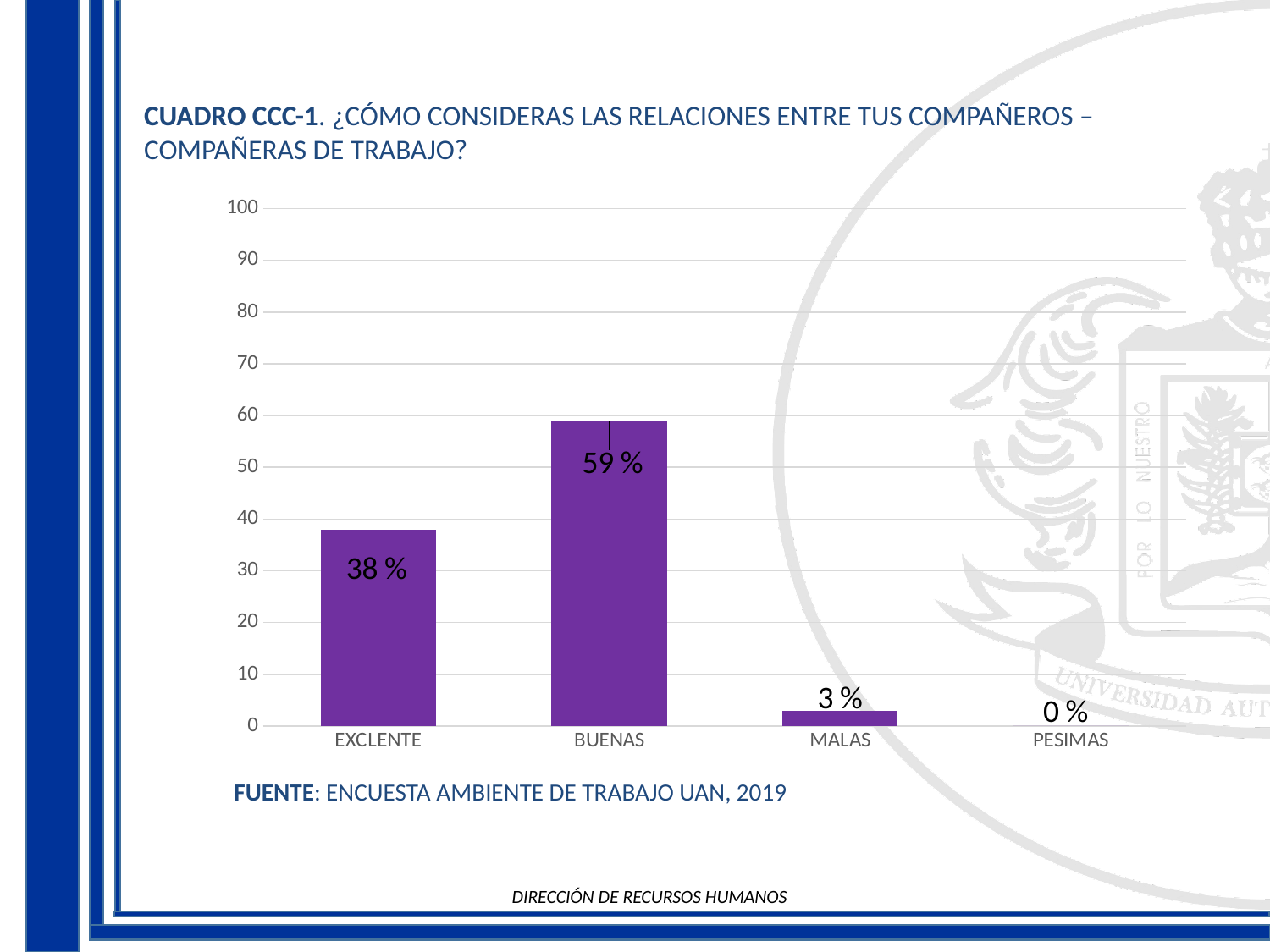
What is the value for MALAS? 3 % How many categories are shown on the x axis? 4 What kind of chart is shown on the slide? bar chart What is the difference between the values for BUENAS and EXCLENTE? 21 % What is the source cited below the chart? ENCUESTA AMBIENTE DE TRABAJO UAN, 2019 What is the value for PESIMAS? 0 % Which category has the lowest value? PESIMAS Which category has the highest value? BUENAS Which is larger, the value for EXCLENTE or the value for MALAS? EXCLENTE Is the value for BUENAS greater or less than 50? greater What is the value for EXCLENTE? 38 % What is the value for BUENAS? 59 %